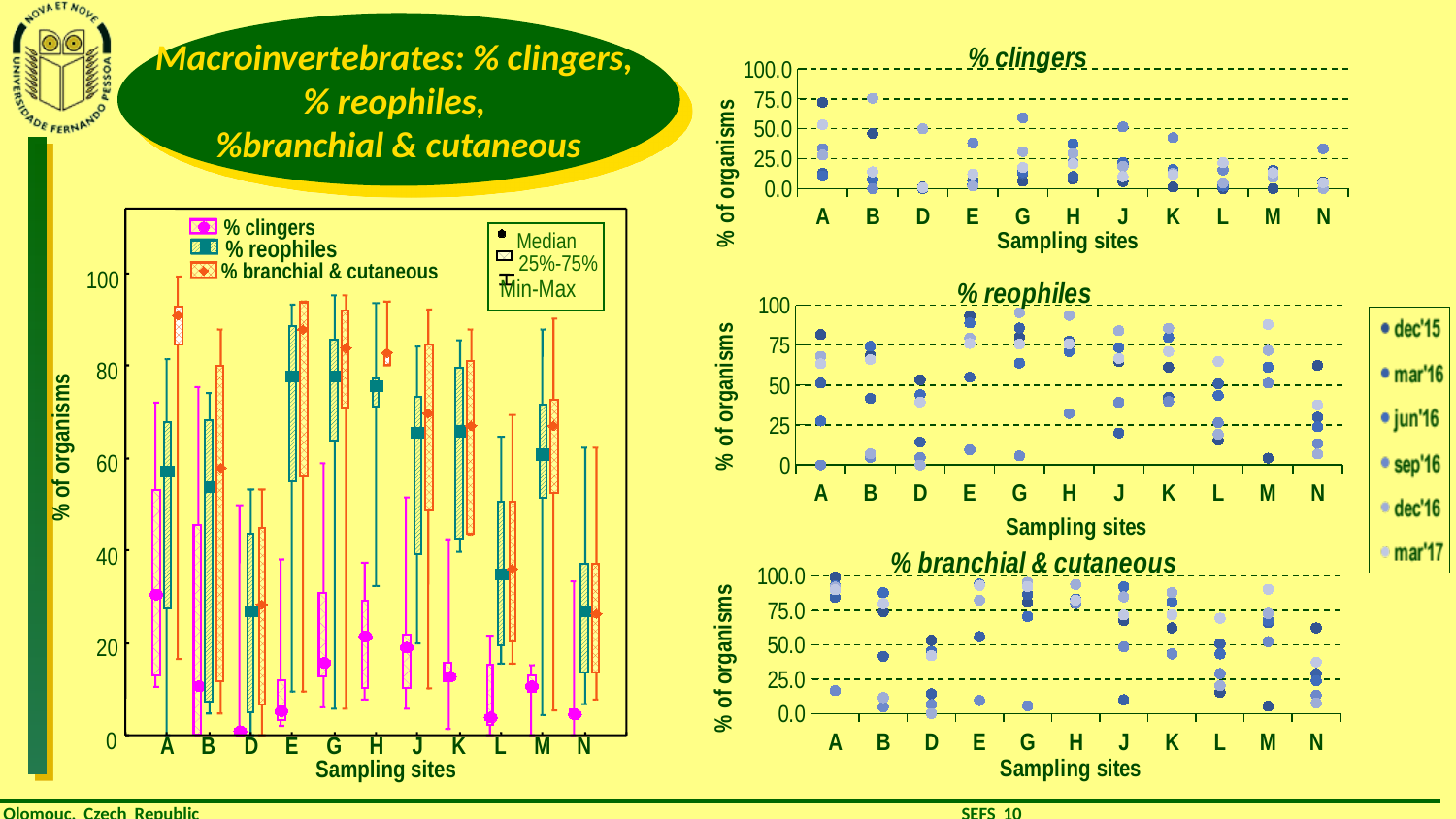
In the left box plot, is the median % clingers at site D greater or less than 20? less What kind of charts are the three charts on the right of the slide? Scatter charts How many charts are on the slide? 4 How many sampling sites are shown on the x axis of the left box plot? 11 In the '% clingers' scatter chart on the right, are all the points for site N greater or less than 50.0? less In the left box plot, at site K, which is larger: the median % reophiles or the median % clingers? % reophiles What is the y-axis label of the '% reophiles' scatter chart on the right? % of organisms In the left box plot, which sampling site has the highest median for % clingers? A How many series does the shared legend of the three scatter charts on the right list? 6 What kind of chart is the large chart on the left of the slide? Box plot How many series does the legend of the left box plot list? 3 In the left box plot, is the median % reophiles at site A greater or less than 50? greater